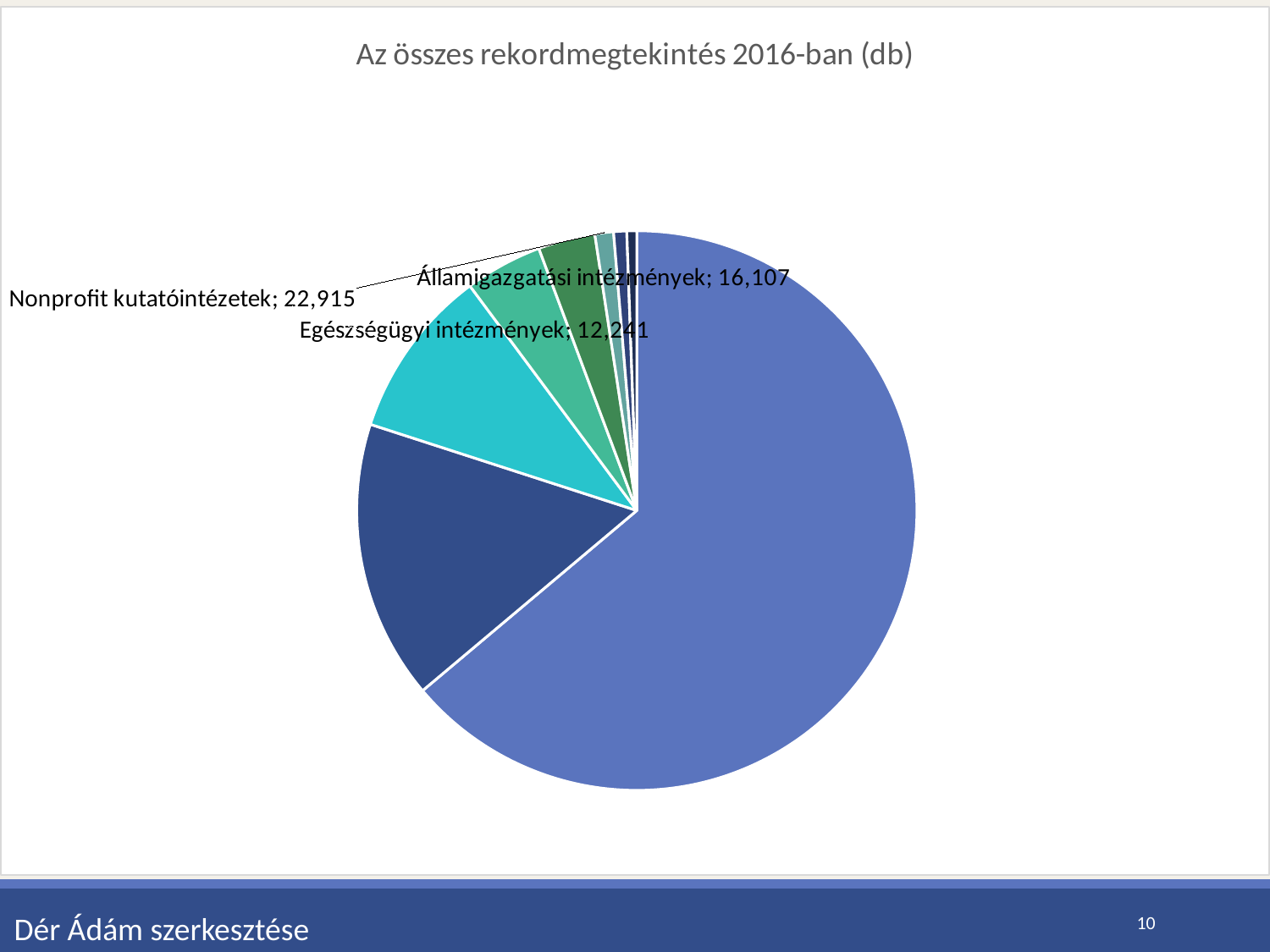
Among the labeled categories, which has the highest value? Nonprofit kutatóintézetek What kind of chart is shown on the slide? pie chart What is the value shown for Államigazgatási intézmények? 16,107 What is the difference between the values for Nonprofit kutatóintézetek and Egészségügyi intézmények? 10,674 What is the difference between the values for Nonprofit kutatóintézetek and Államigazgatási intézmények? 6,808 What is the difference between the values for Államigazgatási intézmények and Egészségügyi intézmények? 3,866 Which is larger, the value for Nonprofit kutatóintézetek or the value for Államigazgatási intézmények? Nonprofit kutatóintézetek What is the title of the chart? Az összes rekordmegtekintés 2016-ban (db) Among the labeled categories, which has the lowest value? Egészségügyi intézmények What is the value shown for Nonprofit kutatóintézetek? 22,915 Which is larger, the value for Államigazgatási intézmények or the value for Egészségügyi intézmények? Államigazgatási intézmények What is the value shown for Egészségügyi intézmények? 12,241